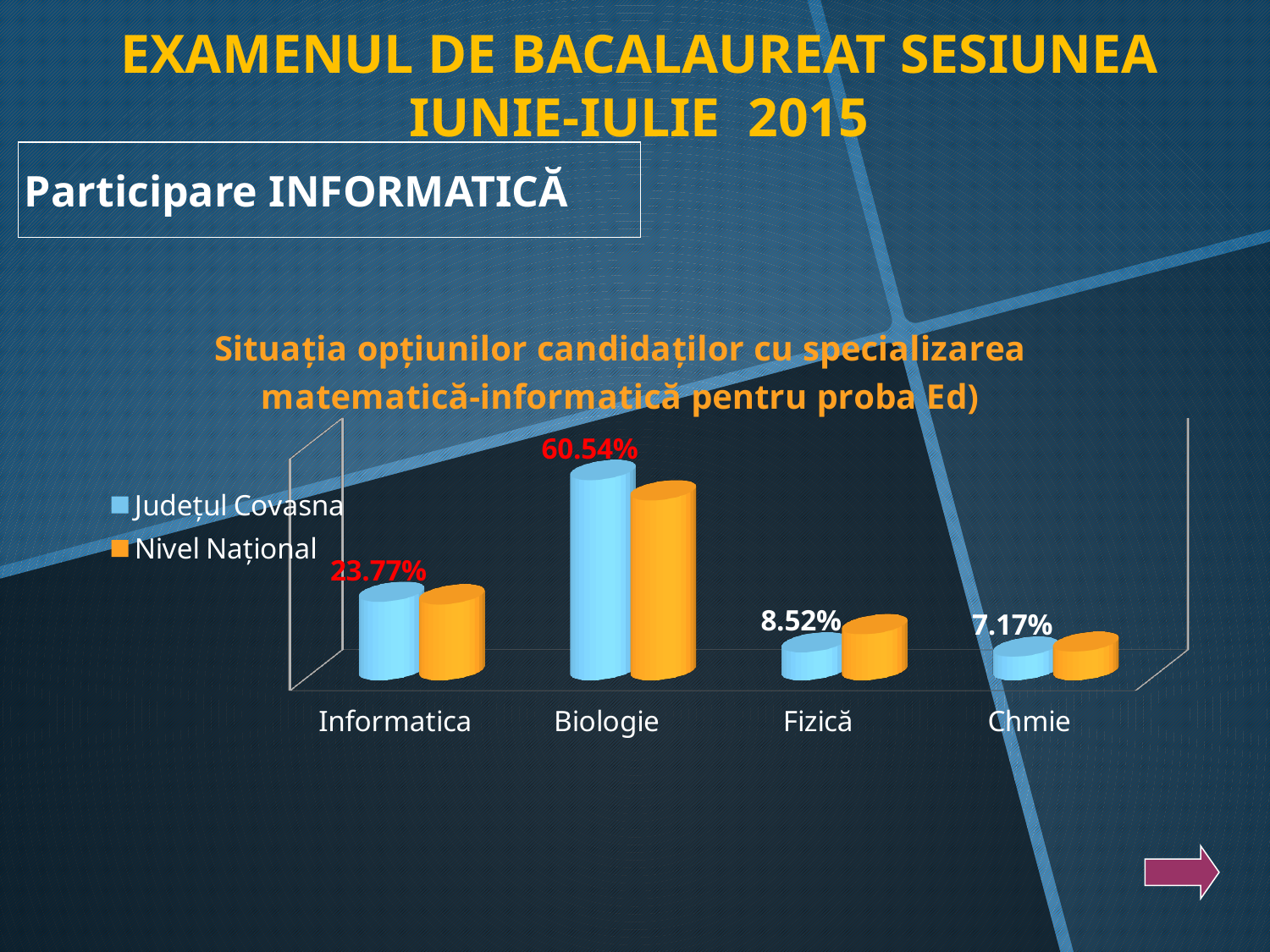
What value is labelled for Fizică on the chart? 8.52% What value is labelled for Chmie on the chart? 7.17% What value is labelled for Informatica on the chart? 23.77% For the Nivel Național series, which is larger: Biologie or Informatica? Biologie Which category has the highest labelled value? Biologie What value is labelled for Biologie on the chart? 60.54% Which category has the lowest labelled value? Chmie How many series does the legend list? 2 What is the difference between the labelled values for Fizică and Chmie? 1.35% What kind of chart is shown on the slide? Bar chart What is the difference between the labelled values for Biologie and Informatica? 36.77% How many categories are shown on the x axis? 4